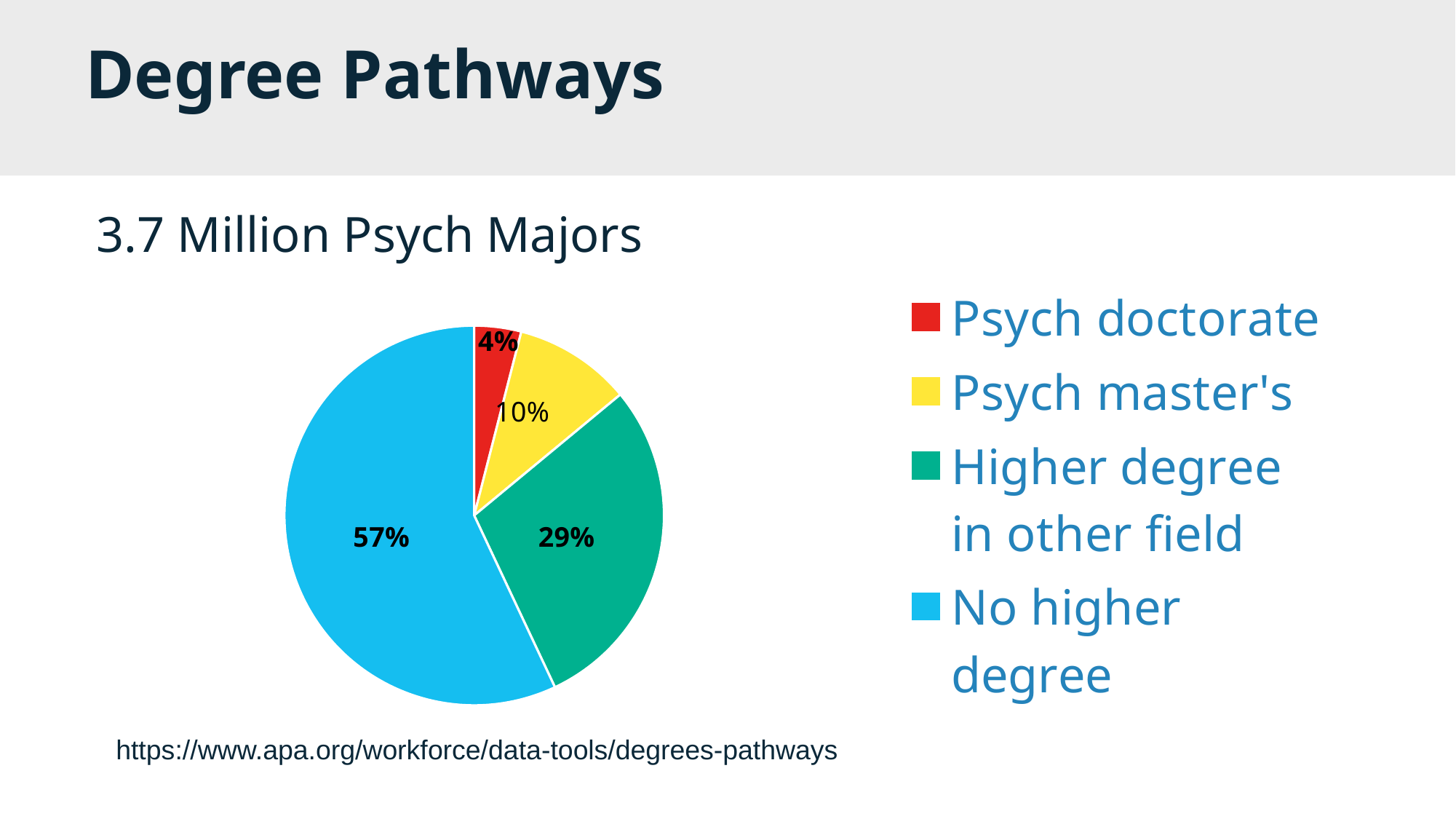
Which is larger, the share for Psych master's or the share for Psych doctorate? Psych master's What share of psych majors have a higher degree in another field? 29% What colour is the slice for Higher degree in other field? Green What kind of chart is shown on the slide? Pie chart How many categories does the pie chart show? 4 What share of psych majors have a psych doctorate? 4% What is the difference in percentage points between No higher degree and Higher degree in other field? 28 Which category has the largest slice of the pie? No higher degree What share of psych majors have a psych master's? 10% What share of psych majors have no higher degree? 57% What is the title shown above the pie chart? 3.7 Million Psych Majors Which category has the smallest slice of the pie? Psych doctorate